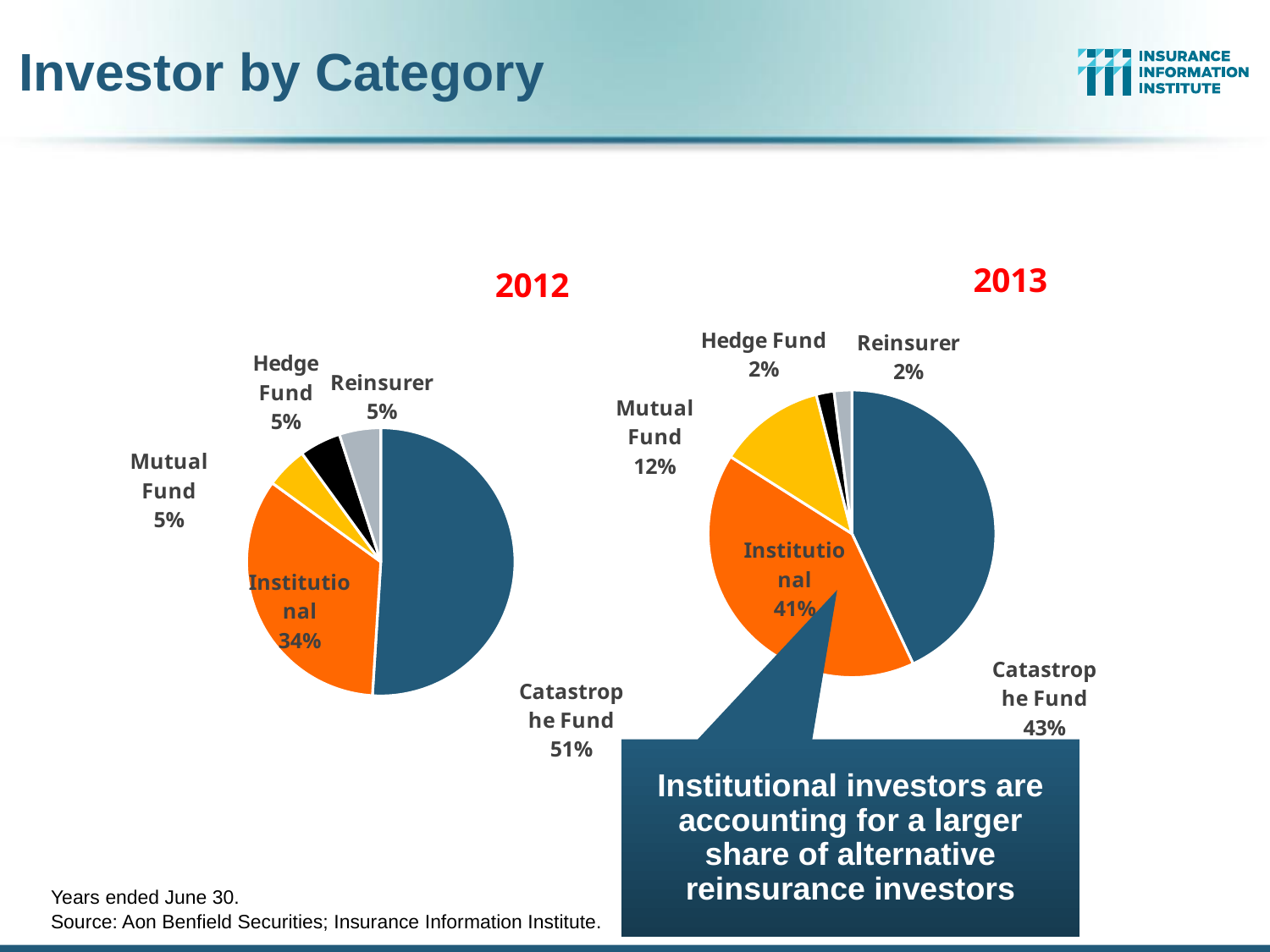
What is the difference in percentage points between the Institutional share in 2013 and in 2012? 7 percentage points In the 2012 pie chart, what share does Institutional have? 34% In the 2013 pie chart, what share does Hedge Fund have? 2% In the 2013 pie chart, which is larger, Mutual Fund or Hedge Fund? Mutual Fund In the 2012 pie chart, what share does Catastrophe Fund have? 51% In the 2013 pie chart, what share does Mutual Fund have? 12% How many categories are shown in the 2013 pie chart? 5 In the 2012 pie chart, what is the difference in percentage points between Catastrophe Fund and Institutional? 17 percentage points In the 2013 pie chart, what share does Institutional have? 41% What type of chart is used to show the 2012 investor breakdown? Pie chart In the 2012 pie chart, which category has the largest share? Catastrophe Fund In the 2013 pie chart, which category has the largest share? Catastrophe Fund